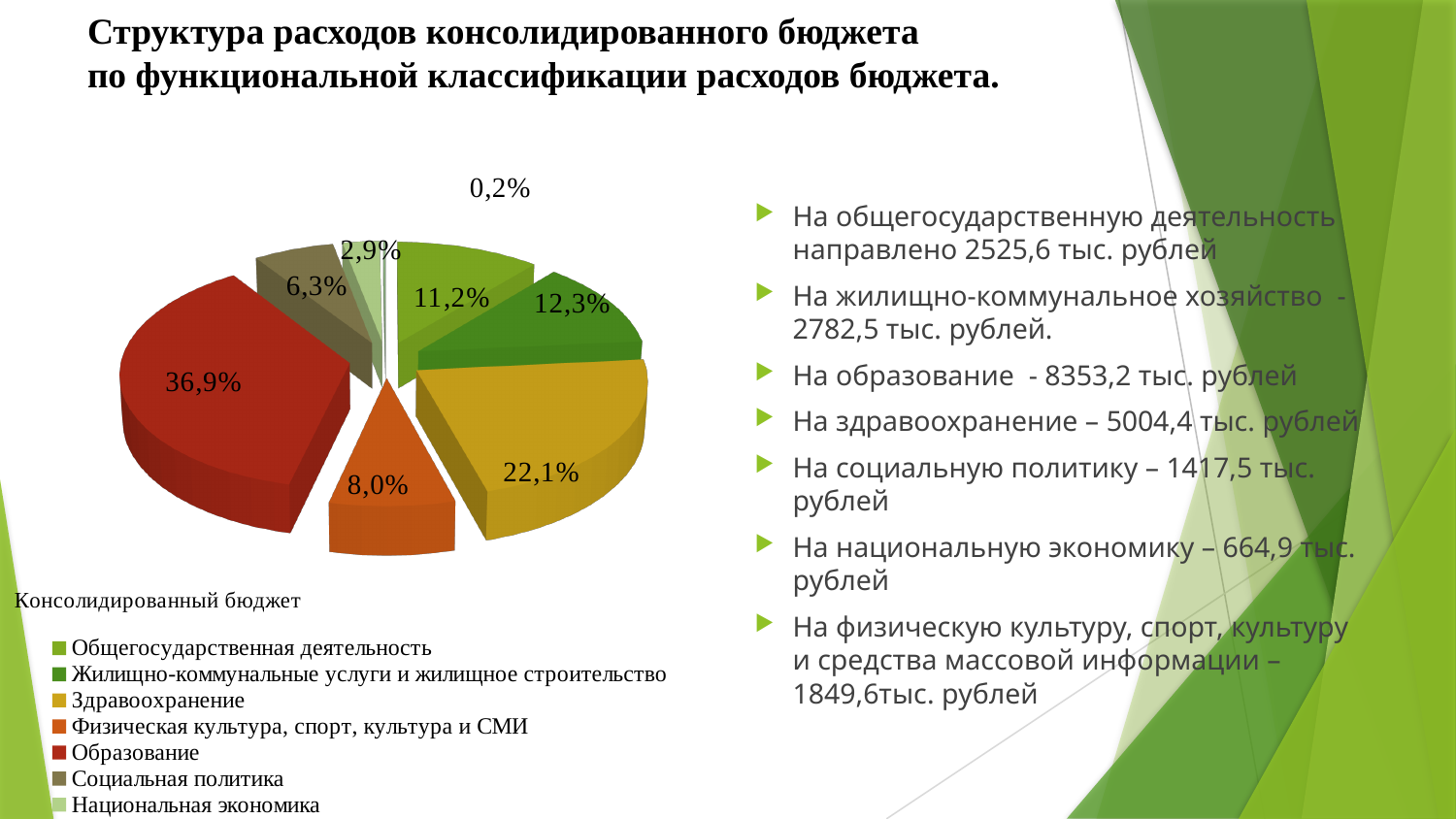
What share of the pie does Общегосударственная деятельность have? 11,2% What share of the pie does Здравоохранение have? 22,1% How many categories are listed in the chart legend? 7 What is the difference in percentage points between the Образование slice and the Здравоохранение slice? 14,8 What share of the pie does Социальная политика have? 6,3% What share of the pie does Физическая культура, спорт, культура и СМИ have? 8,0% What share of the pie does Жилищно-коммунальные услуги и жилищное строительство have? 12,3% Which legend category has the largest slice of the pie? Образование Which is larger, the slice for Здравоохранение or the slice for Жилищно-коммунальные услуги и жилищное строительство? Здравоохранение What share of the pie does Национальная экономика have? 2,9% What share of the pie does Образование have? 36,9% What kind of chart is shown on the slide? pie chart